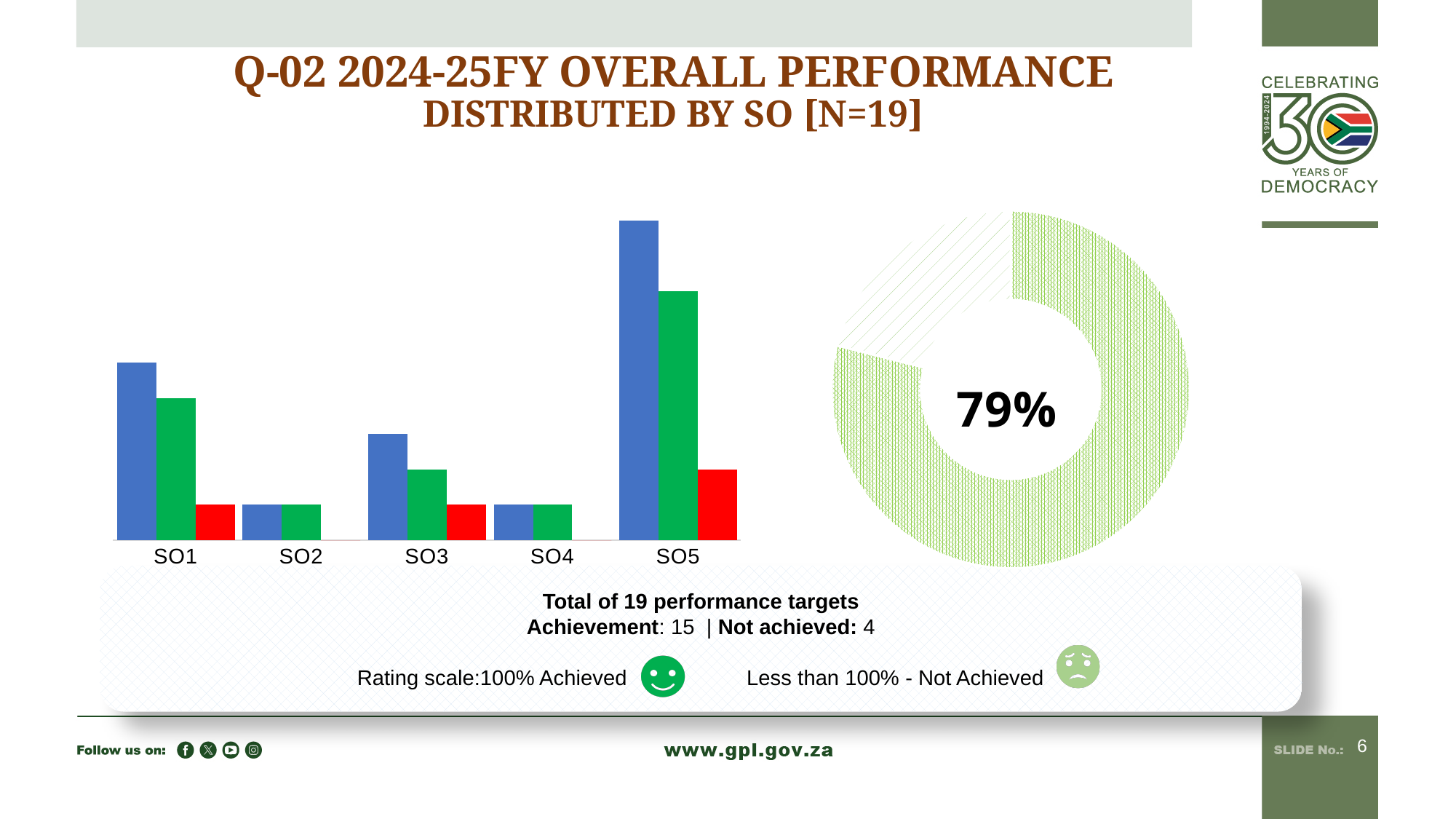
In the bar chart on the left, how many bars are shown for SO5? 3 In the bar chart on the left, how many categories have a red bar? 3 How many categories are shown on the x axis of the bar chart on the left? 5 What kind of chart is the chart on the left of the slide showing SO1 to SO5? bar chart In the bar chart on the left, which category has the tallest green bar? SO5 In the bar chart on the left, is the green bar for SO3 taller or shorter than the green bar for SO1? shorter What kind of chart is the chart on the right of the slide showing 79%? doughnut chart What colours are the three bars shown for SO1 in the bar chart on the left, from left to right? blue, green, red In the bar chart on the left, which category has the tallest red bar? SO5 In the bar chart on the left, is the blue bar for SO1 taller or shorter than the blue bar for SO3? taller In the bar chart on the left, which category has the tallest blue bar? SO5 In the doughnut chart on the right, what percentage is printed in the centre? 79%